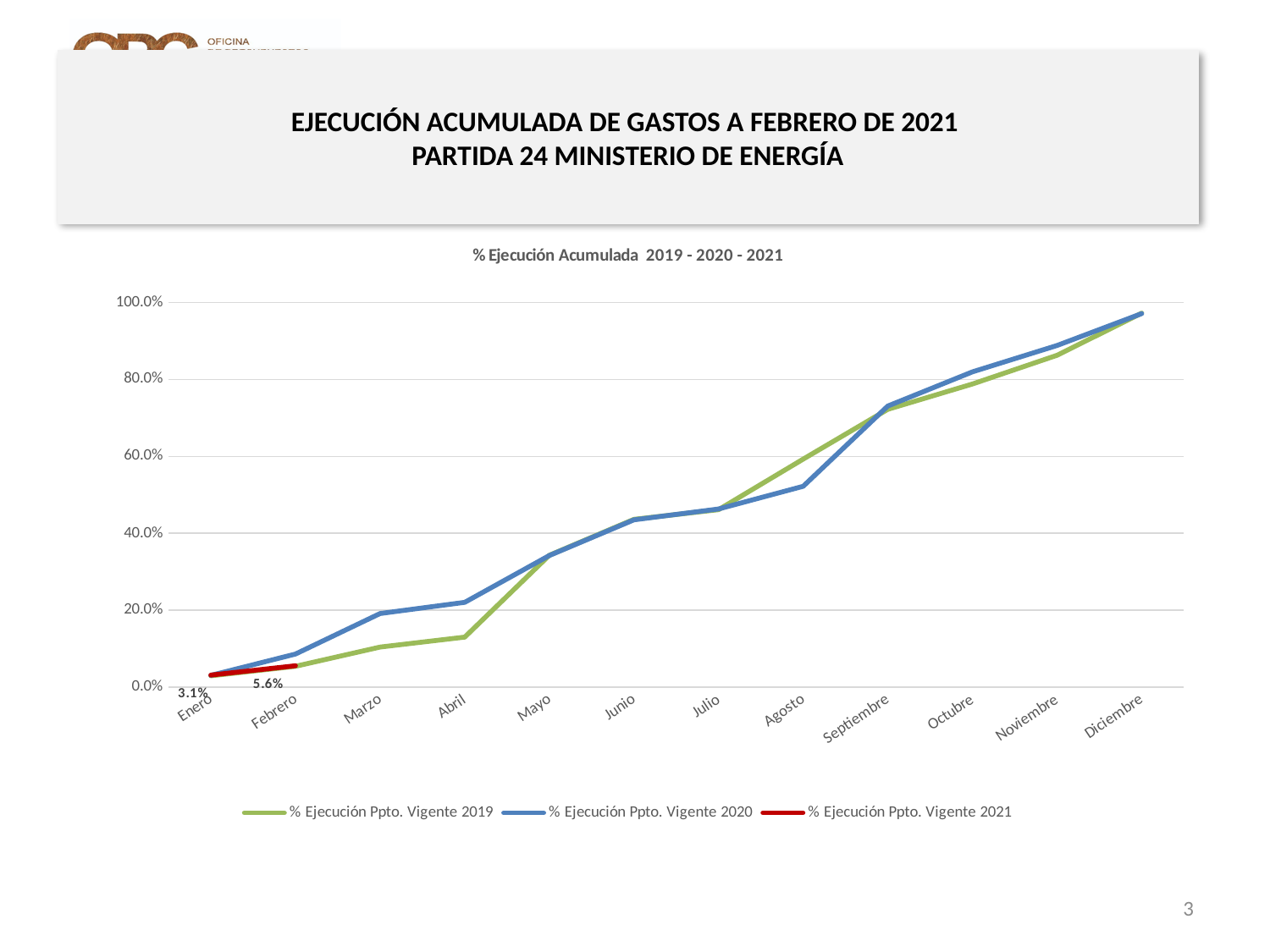
Which series has the higher value in Agosto, % Ejecución Ppto. Vigente 2019 or % Ejecución Ppto. Vigente 2020? % Ejecución Ppto. Vigente 2019 How many months are shown on the x axis of the chart? 12 What is the value of % Ejecución Ppto. Vigente 2021 for Febrero? 5.6% What is the title of the chart? % Ejecución Acumulada 2019 - 2020 - 2021 What is the value of % Ejecución Ppto. Vigente 2021 for Enero? 3.1% How many series does the chart legend list? 3 Is the value for % Ejecución Ppto. Vigente 2019 in Abril greater or less than 20.0%? less Do the values for % Ejecución Ppto. Vigente 2020 rise or fall from Enero to Diciembre? Rise By how much did % Ejecución Ppto. Vigente 2021 increase from Enero to Febrero? 2.5% Is the value for % Ejecución Ppto. Vigente 2020 in Agosto greater or less than 40.0%? greater Which series has the higher value in Marzo, % Ejecución Ppto. Vigente 2019 or % Ejecución Ppto. Vigente 2020? % Ejecución Ppto. Vigente 2020 What kind of chart is shown on the slide? Line chart